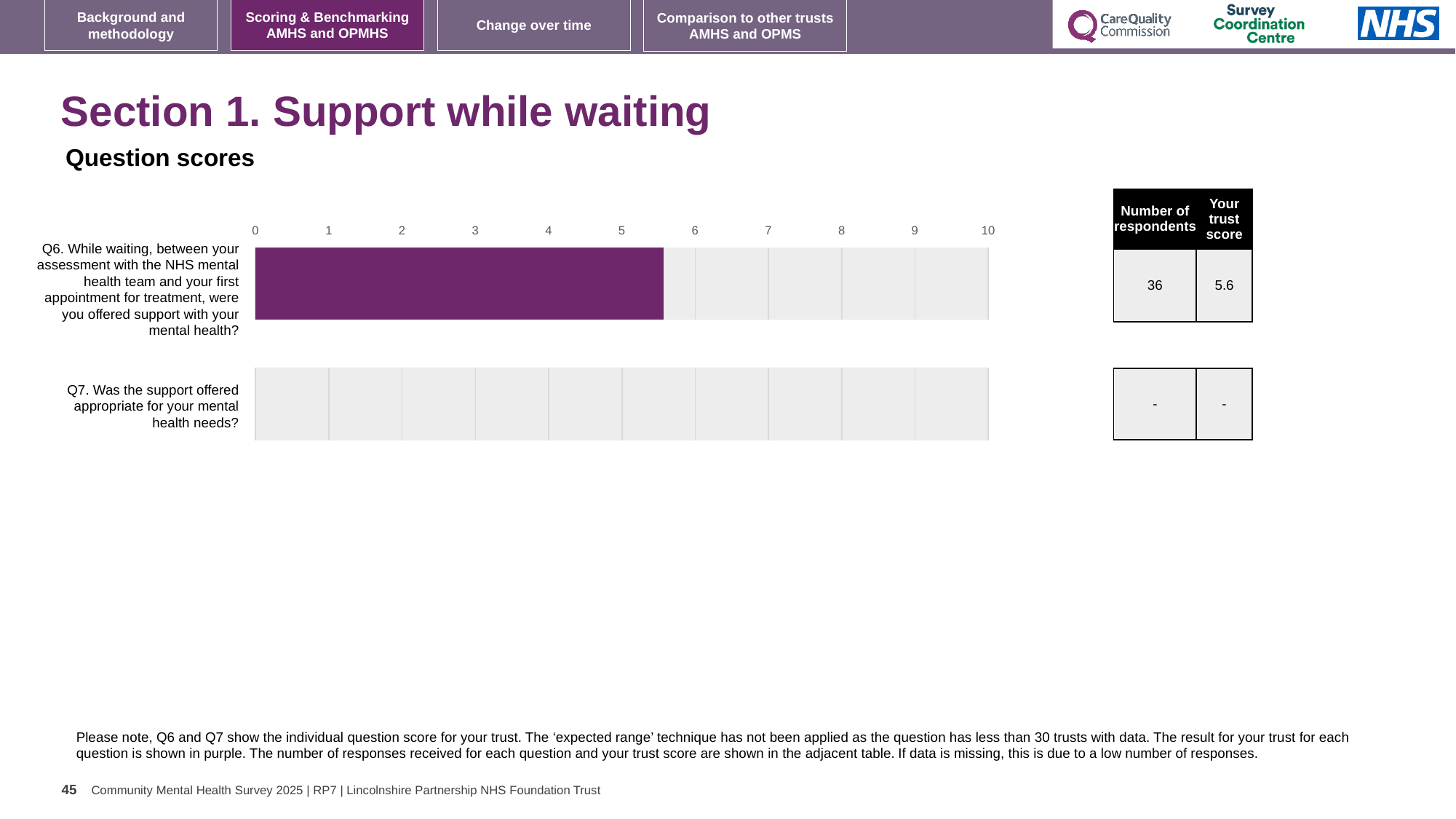
What is the trust score for Q6 shown in the adjacent table? 5.6 What kind of chart is shown on the slide? bar chart Is the value of the bar for Q6 greater or less than 5? greater Is the value of the bar for Q6 greater or less than 6? less What is the maximum value shown on the chart's horizontal axis? 10 How many questions (categories) are listed on the chart? 2 How many respondents are shown for Q6 in the adjacent table? 36 Which question has a purple bar plotted on the chart? Q6 What is shown as the trust score for Q7 in the adjacent table? - What colour is the bar for Q6? purple What is shown as the number of respondents for Q7 in the adjacent table? -